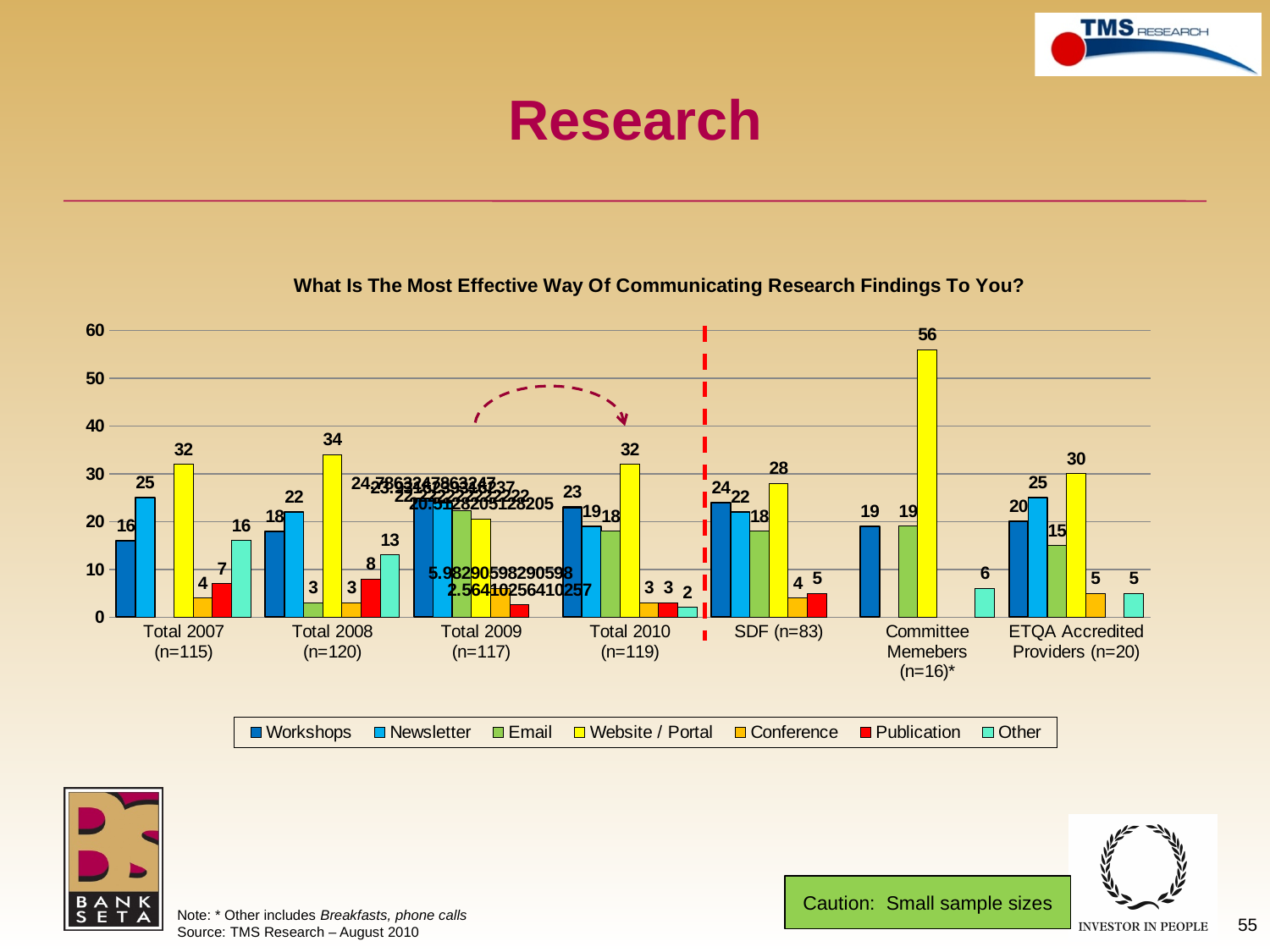
How many series does the legend list? 7 What kind of chart is shown on the slide? bar chart What is the value for Website / Portal in the Committee Memebers (n=16)* group? 56 What is the difference between the Website / Portal values for Total 2008 (n=120) and Total 2007 (n=115)? 2 Which series has the lowest value in the Total 2010 (n=119) group? Other What is the value for Other in the Total 2008 (n=120) group? 13 What is the value for Newsletter in the ETQA Accredited Providers (n=20) group? 25 Is the value for Website / Portal in the Committee Memebers (n=16)* group greater or less than 50? greater Which series has the highest value in the Committee Memebers (n=16)* group? Website / Portal In the SDF (n=83) group, which is larger: Workshops or Newsletter? Workshops How many groups are shown on the x axis? 7 What is the value for Workshops in the Total 2010 (n=119) group? 23